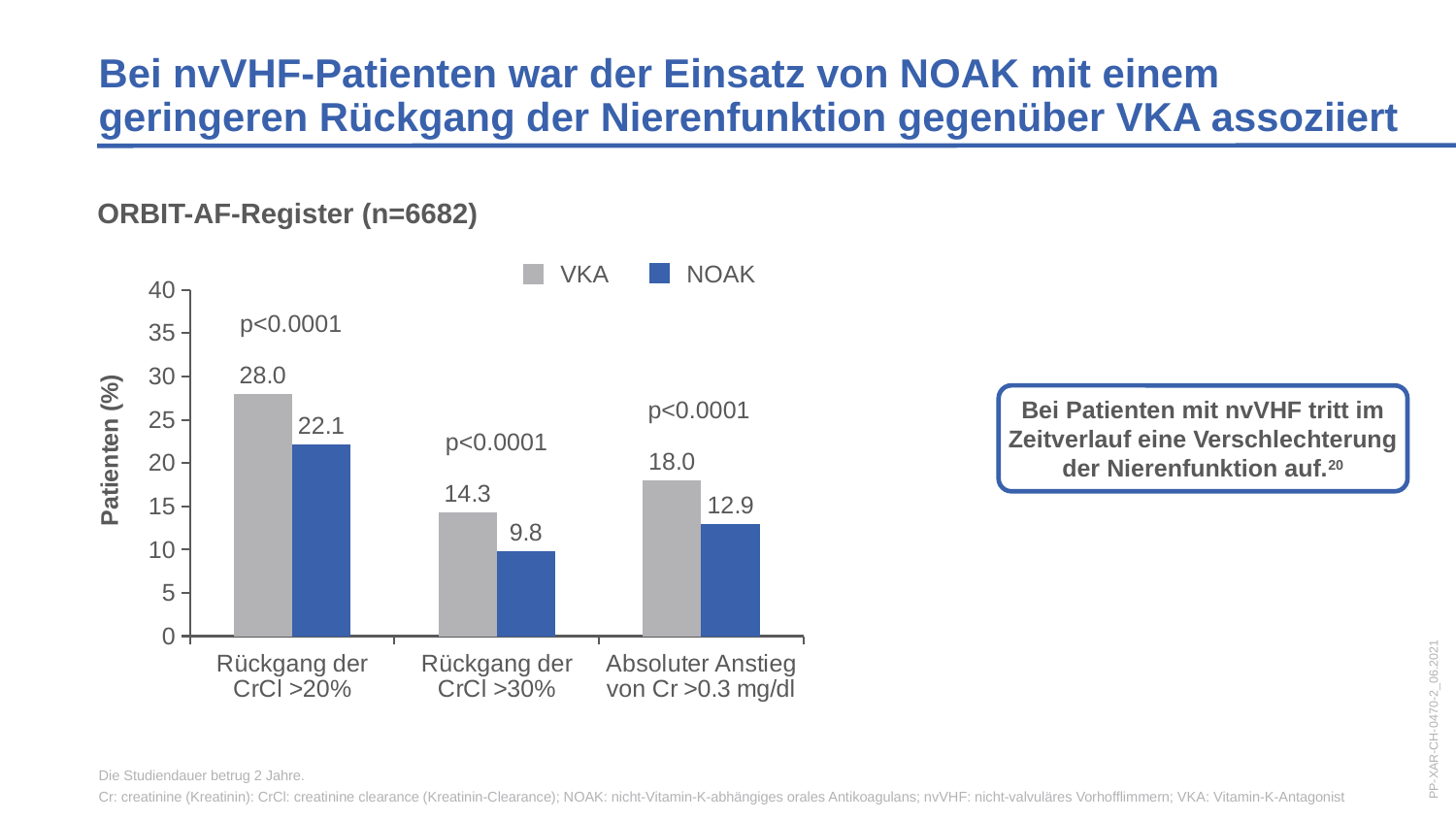
What is the NOAK value for 'Absoluter Anstieg von Cr >0.3 mg/dl'? 12.9 What is the NOAK value for 'Rückgang der CrCl >30%'? 9.8 For 'Rückgang der CrCl >30%', which is larger: the VKA value or the NOAK value? VKA What kind of chart is shown on the slide? Bar chart What is the label of the y axis? Patienten (%) Which category has the highest VKA value? Rückgang der CrCl >20% What is the difference between the VKA and NOAK values for 'Absoluter Anstieg von Cr >0.3 mg/dl'? 5.1 What is the difference between the VKA and NOAK values for 'Rückgang der CrCl >20%'? 5.9 How many series does the legend list? 2 What is the VKA value for 'Rückgang der CrCl >20%'? 28.0 How many categories are shown on the x axis? 3 Which category has the lowest NOAK value? Rückgang der CrCl >30%